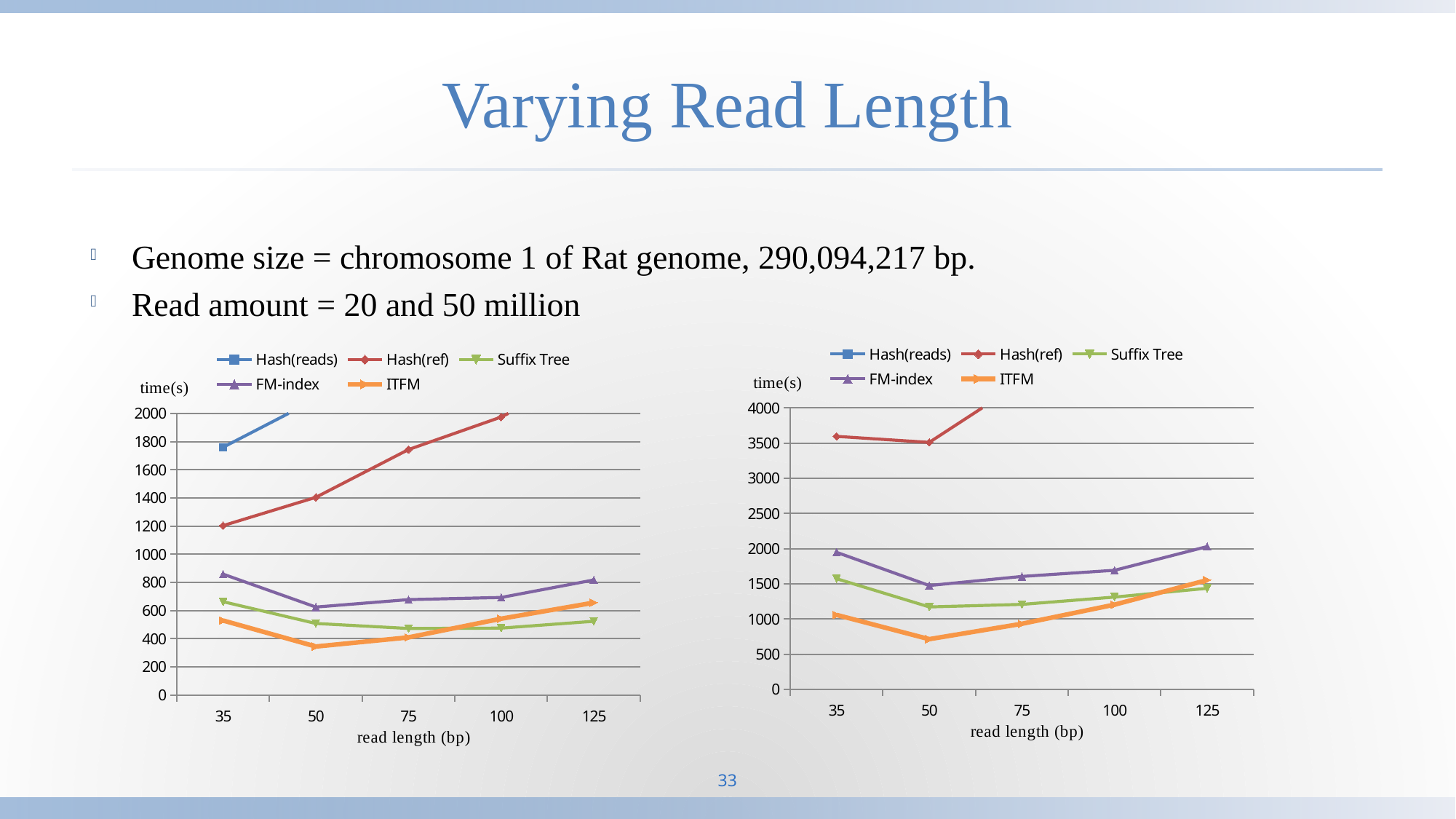
In the left chart, which is larger at read length 125: FM-index or Suffix Tree? FM-index In the left chart, which series has the lowest value at read length 50? ITFM In the right chart, is the value for ITFM at read length 50 greater or less than 1000? less In the right chart, is the value for Hash(ref) at read length 35 greater or less than 3000? greater What kind of chart is the left chart on the slide? line chart How many series does the legend of the right chart list? 5 How many read length values are shown on the x axis of the left chart? 5 In the left chart, does the Hash(ref) line rise or fall as read length increases from 35 to 100? rise What is the label on the x axis of the right chart? read length (bp) In the left chart, is the value for ITFM at read length 50 greater or less than 400? less